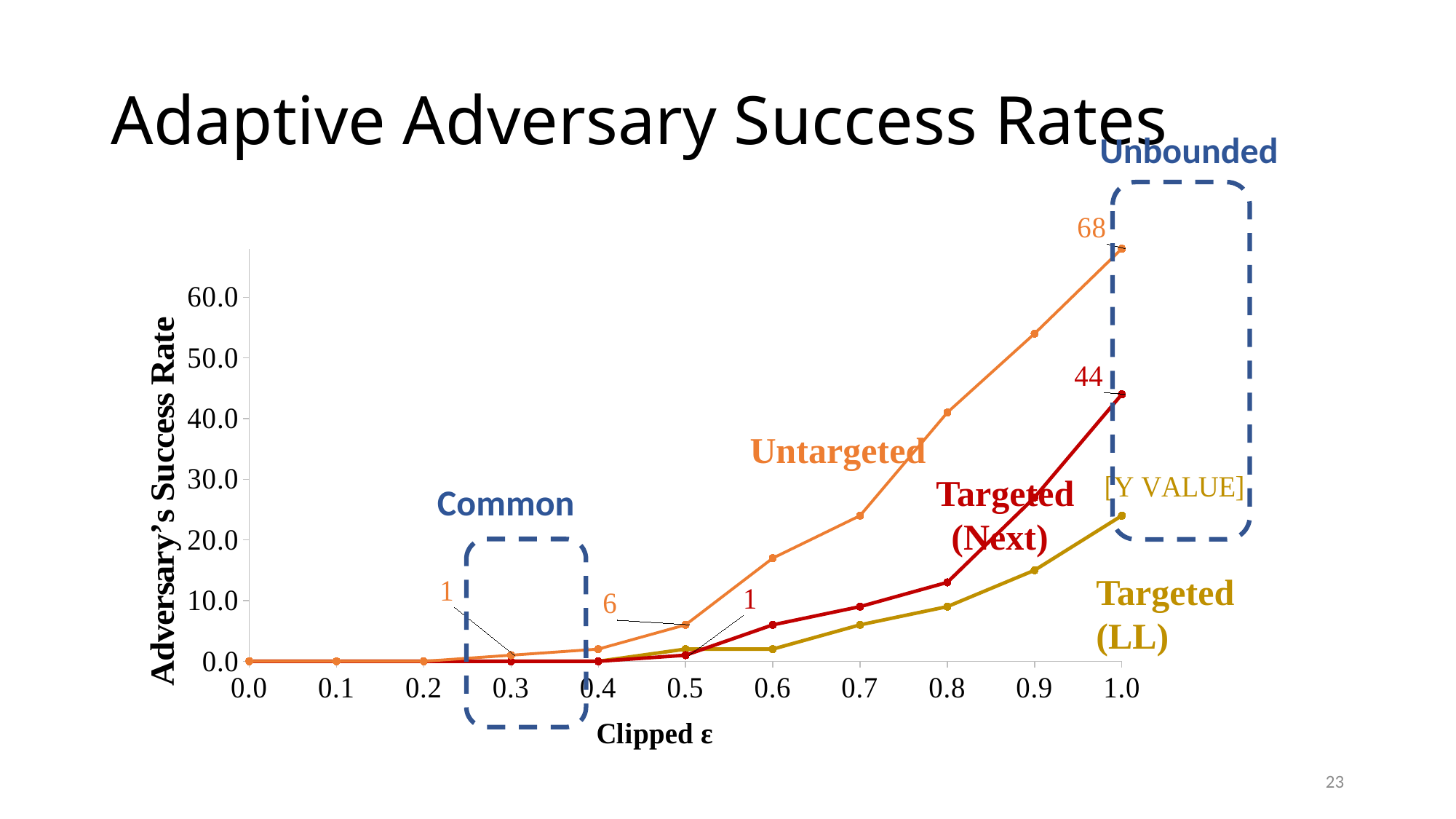
Does the Untargeted success rate rise or fall as clipped ε increases from 0.0 to 1.0? rise Is the Targeted (LL) success rate at clipped ε = 1.0 greater or less than 20.0? greater What is the Targeted (Next) success rate at clipped ε = 0.5? 1 What is the Targeted (Next) success rate at clipped ε = 1.0? 44 At clipped ε = 1.0, what is the difference between the Untargeted and Targeted (Next) success rates? 24 Which series has the lowest success rate at clipped ε = 1.0? Targeted (LL) What kind of chart is shown on the slide? line chart What is the Untargeted success rate at clipped ε = 0.5? 6 What is the Untargeted success rate at clipped ε = 1.0? 68 Which series has the highest success rate at clipped ε = 1.0? Untargeted What is the title of the x axis? Clipped ε What is the Untargeted success rate at clipped ε = 0.3? 1